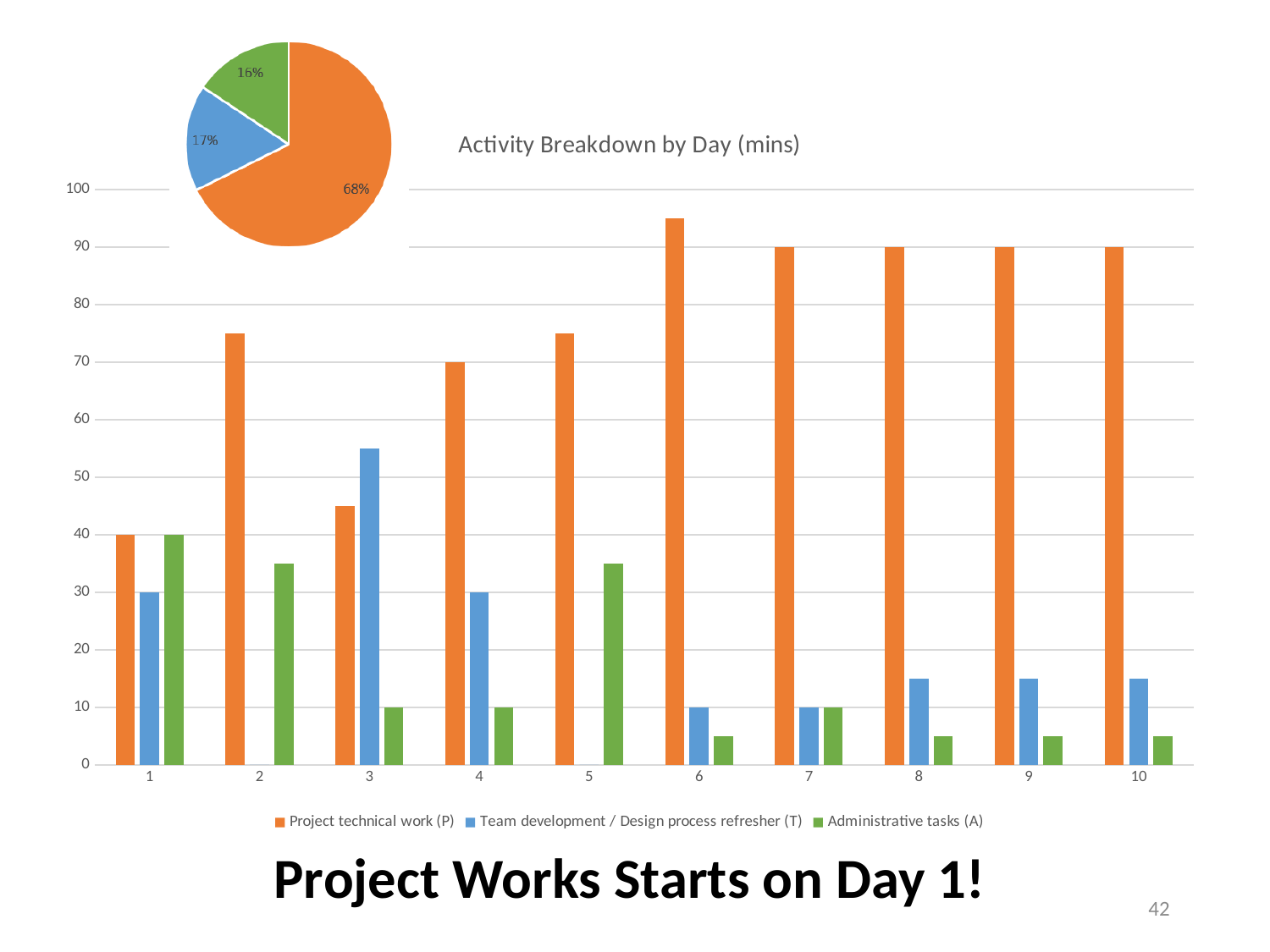
In the bar chart 'Activity Breakdown by Day (mins)', what is the difference between Project technical work (P) on day 7 and on day 1? 50 In the bar chart 'Activity Breakdown by Day (mins)', on which day is Project technical work (P) lowest? 1 In the bar chart 'Activity Breakdown by Day (mins)', is the value for Project technical work (P) on day 2 greater or less than 70? greater In the bar chart 'Activity Breakdown by Day (mins)', is the value for Team development / Design process refresher (T) on day 3 greater or less than 50? greater In the bar chart 'Activity Breakdown by Day (mins)', what is the value for Team development / Design process refresher (T) on day 4? 30 In the bar chart 'Activity Breakdown by Day (mins)', which is larger on day 3: Project technical work (P) or Team development / Design process refresher (T)? Team development / Design process refresher (T) In the bar chart 'Activity Breakdown by Day (mins)', what is the value for Project technical work (P) on day 1? 40 In the bar chart 'Activity Breakdown by Day (mins)', on which day is Project technical work (P) highest? 6 In the pie chart at the top left of the slide, what share does the largest (orange) slice have? 68% In the bar chart 'Activity Breakdown by Day (mins)', what is the value for Project technical work (P) on day 7? 90 How many series does the legend of the bar chart 'Activity Breakdown by Day (mins)' list? 3 In the bar chart 'Activity Breakdown by Day (mins)', what is the value for Administrative tasks (A) on day 3? 10